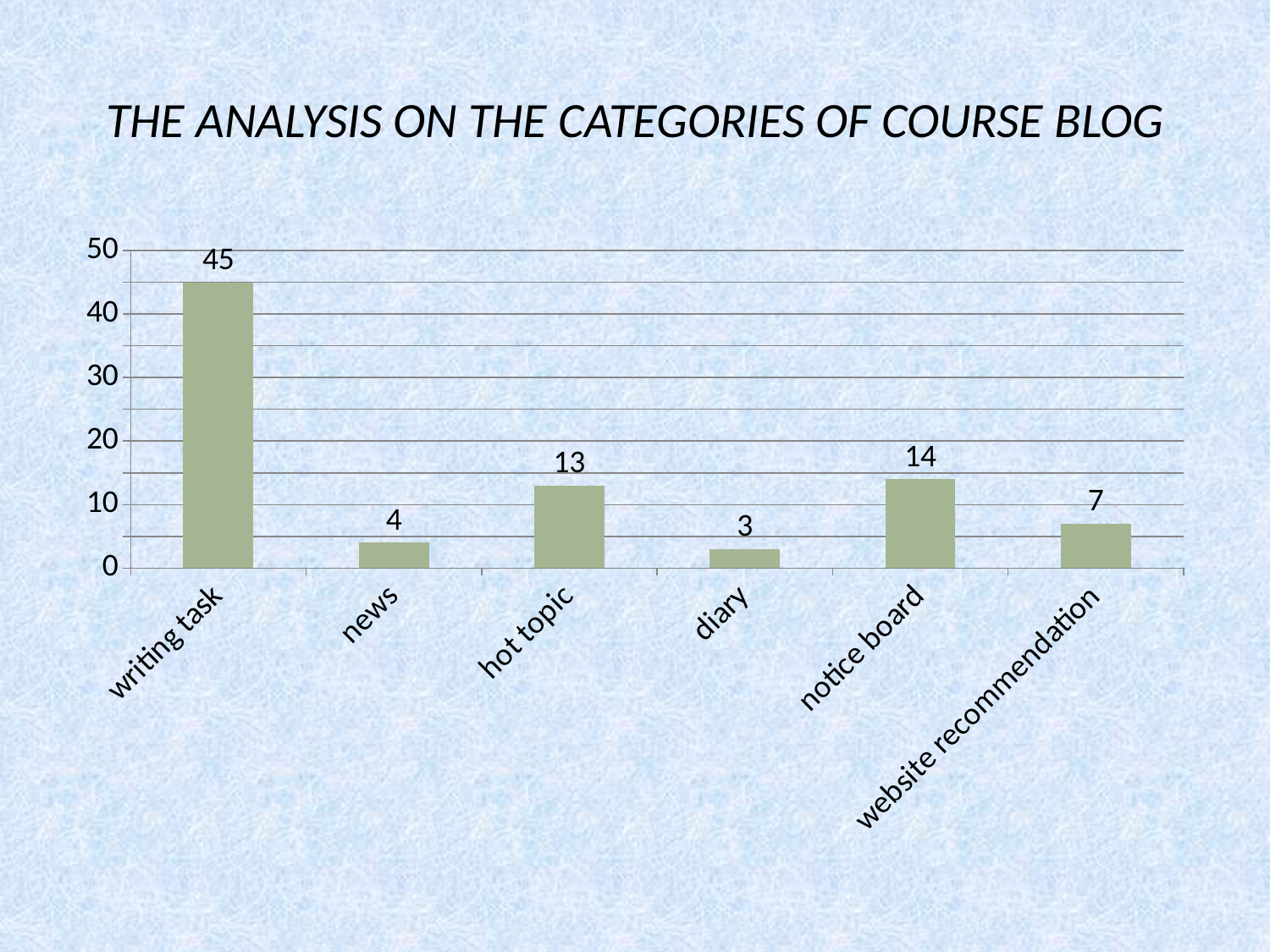
How many categories are shown on the x axis? 6 Is the value for notice board greater or less than 10? greater What is the value for website recommendation? 7 What is the title of the chart on the slide? THE ANALYSIS ON THE CATEGORIES OF COURSE BLOG What is the value for writing task? 45 Which category has the lowest value? diary Which is larger, the value for hot topic or the value for website recommendation? hot topic What kind of chart is shown on the slide? bar chart What is the difference between the values for writing task and notice board? 31 Which category has the highest value? writing task What is the value for notice board? 14 What is the difference between the values for hot topic and news? 9